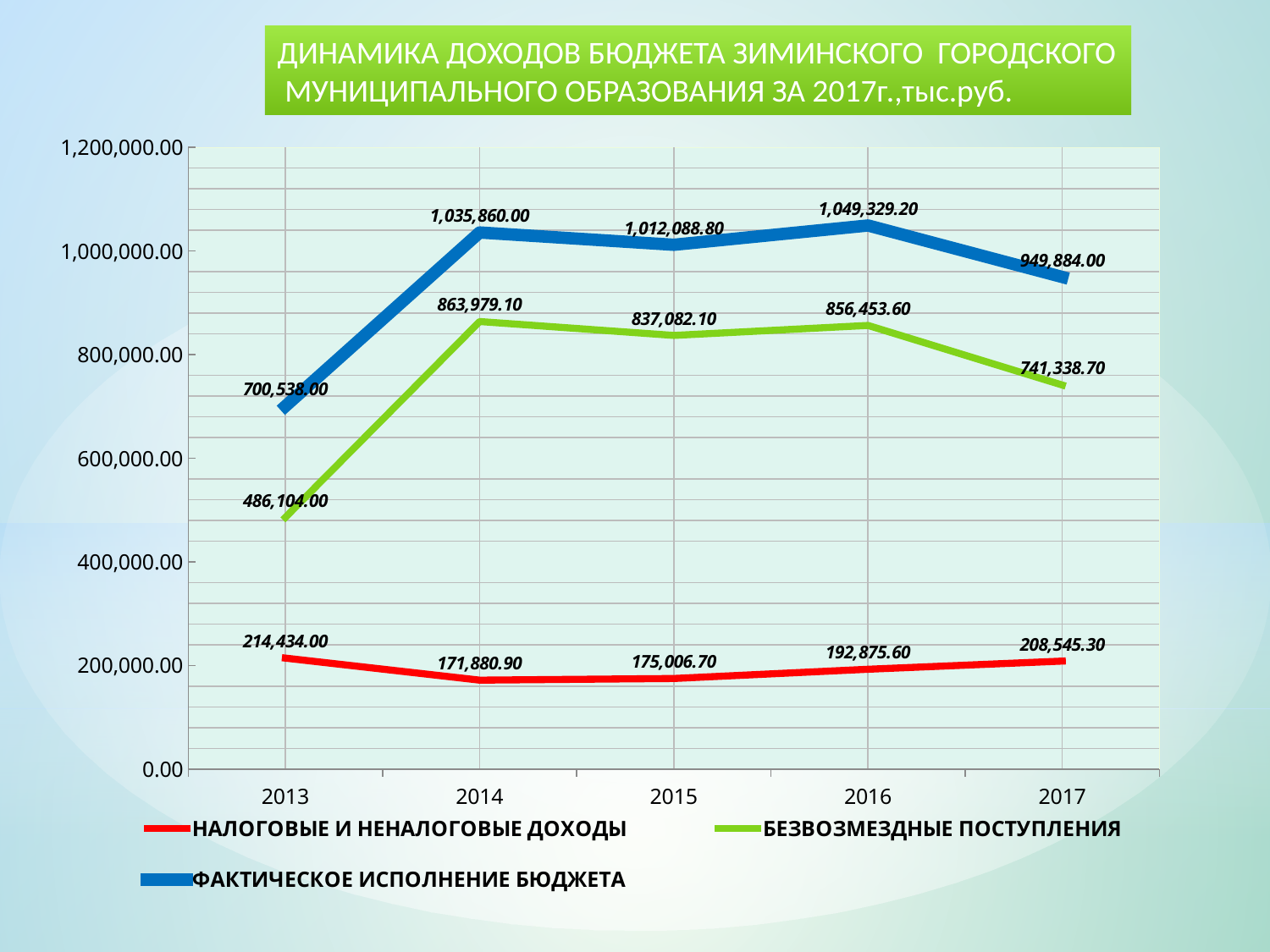
What is the value of ФАКТИЧЕСКОЕ ИСПОЛНЕНИЕ БЮДЖЕТА in 2016? 1,049,329.20 In which year is ФАКТИЧЕСКОЕ ИСПОЛНЕНИЕ БЮДЖЕТА highest? 2016 What is the difference between БЕЗВОЗМЕЗДНЫЕ ПОСТУПЛЕНИЯ in 2014 and in 2017? 122,640.40 In which year is БЕЗВОЗМЕЗДНЫЕ ПОСТУПЛЕНИЯ lowest? 2013 How many series does the legend list? 3 What kind of chart is shown on the slide? Line chart In which year is НАЛОГОВЫЕ И НЕНАЛОГОВЫЕ ДОХОДЫ lowest? 2014 What is the value of НАЛОГОВЫЕ И НЕНАЛОГОВЫЕ ДОХОДЫ in 2013? 214,434.00 What is the difference between ФАКТИЧЕСКОЕ ИСПОЛНЕНИЕ БЮДЖЕТА in 2016 and in 2013? 348,791.20 What is the value of БЕЗВОЗМЕЗДНЫЕ ПОСТУПЛЕНИЯ in 2017? 741,338.70 How many years are shown on the x axis? 5 Which is larger: БЕЗВОЗМЕЗДНЫЕ ПОСТУПЛЕНИЯ in 2015 or in 2016? 2016